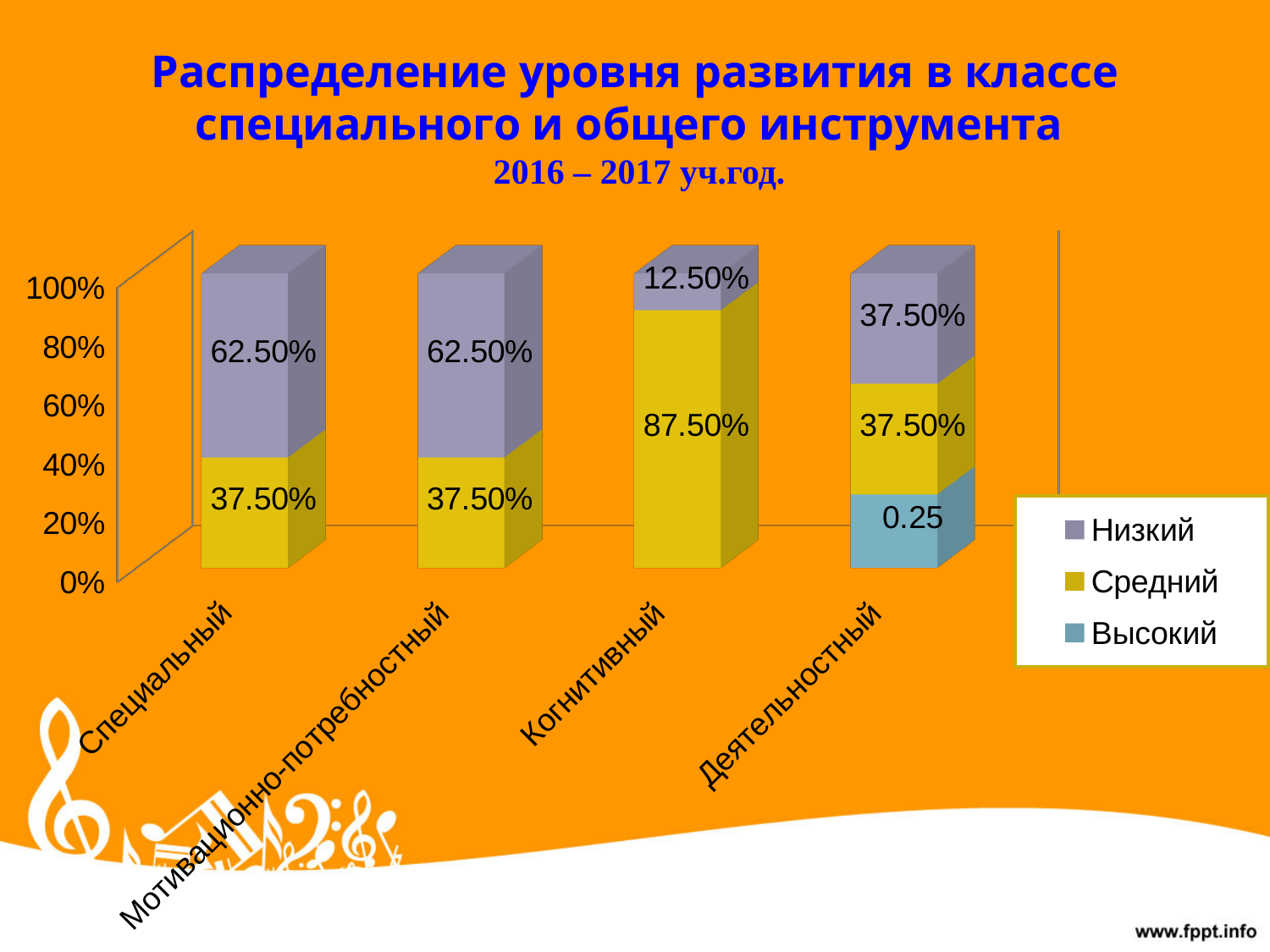
Which series is shown in yellow in the legend? Средний What kind of chart is shown on the slide? stacked bar chart How many series does the legend list? 3 Which category has the lowest value for Низкий? Когнитивный How many categories are shown along the x axis? 4 What is the value of Низкий for Специальный? 62.50% What is the value of Высокий for Деятельностный? 0.25 What is the difference between the Низкий and Средний values for Специальный? 25.00% Which category has the highest value for Средний? Когнитивный What is the value of Средний for Когнитивный? 87.50% What is the value of Средний for Мотивационно-потребностный? 37.50% What is the value of Низкий for Когнитивный? 12.50%